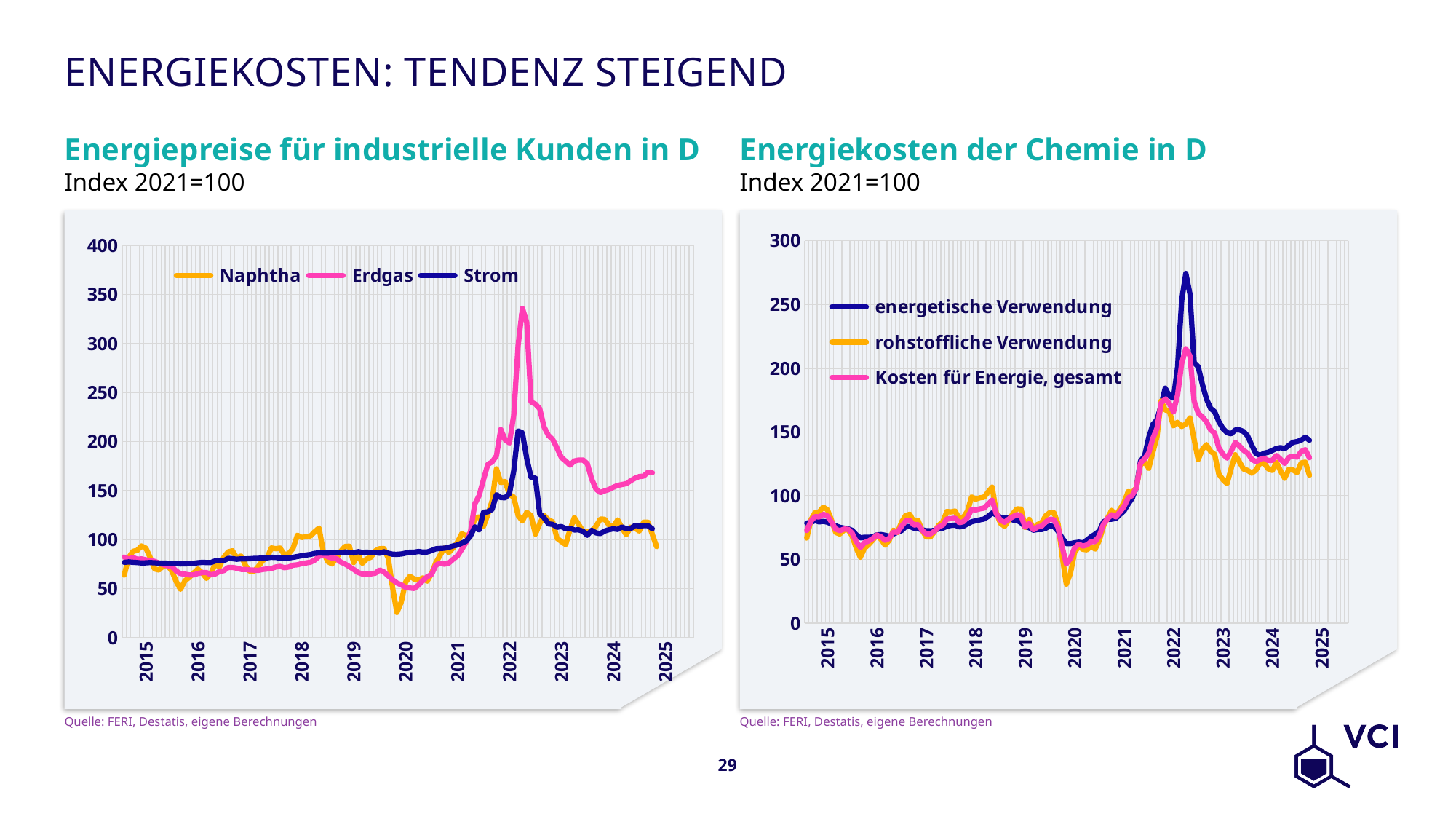
How many series does the legend of the left chart, 'Energiepreise für industrielle Kunden in D', list? 3 In the left chart, 'Energiepreise für industrielle Kunden in D', is the peak value of Erdgas in 2022 greater or less than 300? greater In the right chart, 'Energiekosten der Chemie in D', do the values of 'Kosten für Energie, gesamt' rise or fall between 2021 and 2022? rise What kind of chart is the left chart, 'Energiepreise für industrielle Kunden in D'? line chart What base year is used for the index in both charts, as stated in the subtitles? 2021=100 In the right chart, 'Energiekosten der Chemie in D', is the peak value of 'energetische Verwendung' in 2022 greater or less than 250? greater In the left chart, 'Energiepreise für industrielle Kunden in D', what is the highest value shown on the vertical axis? 400 In the right chart, 'Energiekosten der Chemie in D', which series reaches the highest peak? energetische Verwendung In the left chart, 'Energiepreise für industrielle Kunden in D', is the lowest value of Naphtha around 2020 greater or less than 50? less In the left chart, 'Energiepreise für industrielle Kunden in D', which series reaches the highest peak? Erdgas How many series does the legend of the right chart, 'Energiekosten der Chemie in D', list? 3